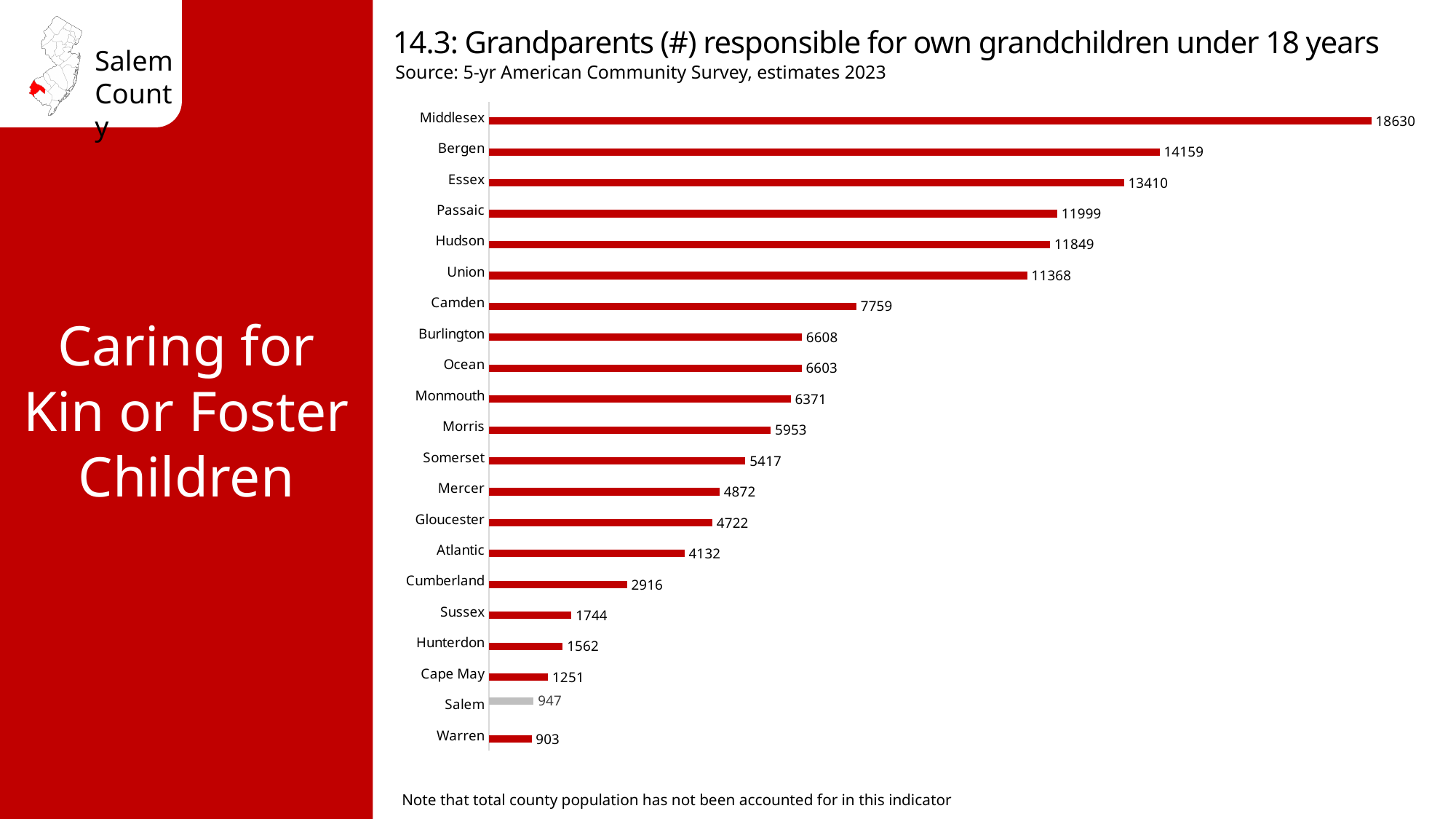
What is the difference between the values for Bergen and Essex? 749 Which has a larger value, Camden or Burlington? Camden What is the difference between the values for Salem and Warren? 44 What is the number of grandparents responsible for own grandchildren in Salem County? 947 Which county has the highest number of grandparents responsible for own grandchildren? Middlesex What is the value shown for Cumberland? 2916 How many counties are shown on the chart? 21 What kind of chart is shown on the slide? Bar chart What is the value shown for Middlesex? 18630 Which county's bar is shown in grey rather than red? Salem Which county has the lowest value on the chart? Warren Which has a larger value, Gloucester or Atlantic? Gloucester